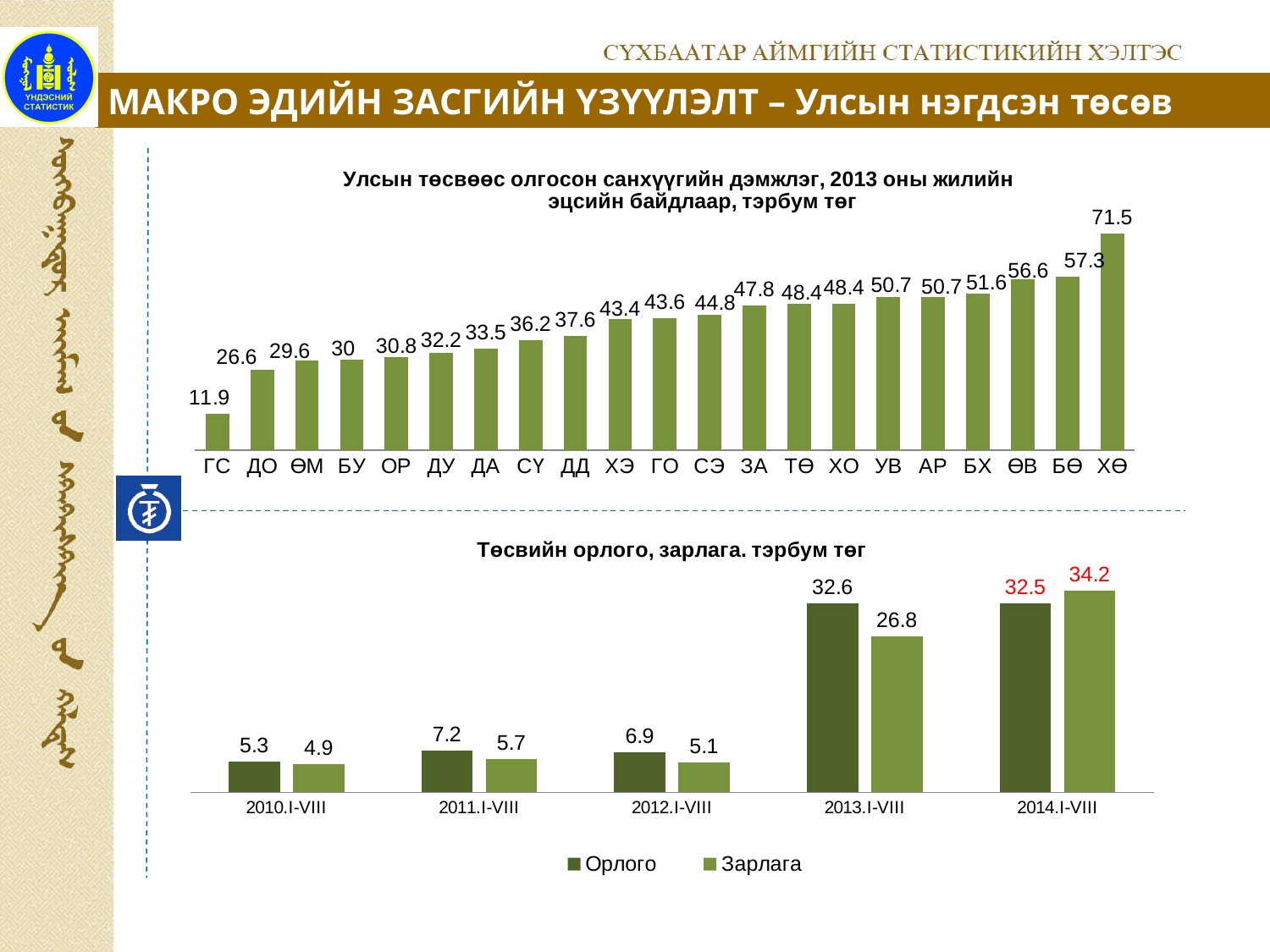
What kind of chart is the bottom chart (Төсвийн орлого, зарлага)? bar chart In the bottom chart (Төсвийн орлого, зарлага), what is the Зарлага value for 2014.I-VIII? 34.2 In the bottom chart (Төсвийн орлого, зарлага), which is larger for 2013.I-VIII, Орлого or Зарлага? Орлого In the bottom chart (Төсвийн орлого, зарлага), which period has the highest Орлого value? 2013.I-VIII In the top chart (Улсын төсвөөс олгосон санхүүгийн дэмжлэг), how many categories are shown? 21 In the top chart (Улсын төсвөөс олгосон санхүүгийн дэмжлэг), what is the difference between the values for ХӨ and БӨ? 14.2 In the bottom chart (Төсвийн орлого, зарлага), what is the difference between Орлого and Зарлага for 2013.I-VIII? 5.8 In the top chart (Улсын төсвөөс олгосон санхүүгийн дэмжлэг), do the values generally rise or fall from left to right? rise In the top chart (Улсын төсвөөс олгосон санхүүгийн дэмжлэг), what is the value for СҮ? 36.2 In the top chart (Улсын төсвөөс олгосон санхүүгийн дэмжлэг), what is the value for ХӨ? 71.5 In the bottom chart (Төсвийн орлого, зарлага), how many series does the legend list? 2 In the top chart (Улсын төсвөөс олгосон санхүүгийн дэмжлэг), which category has the lowest value? ГС